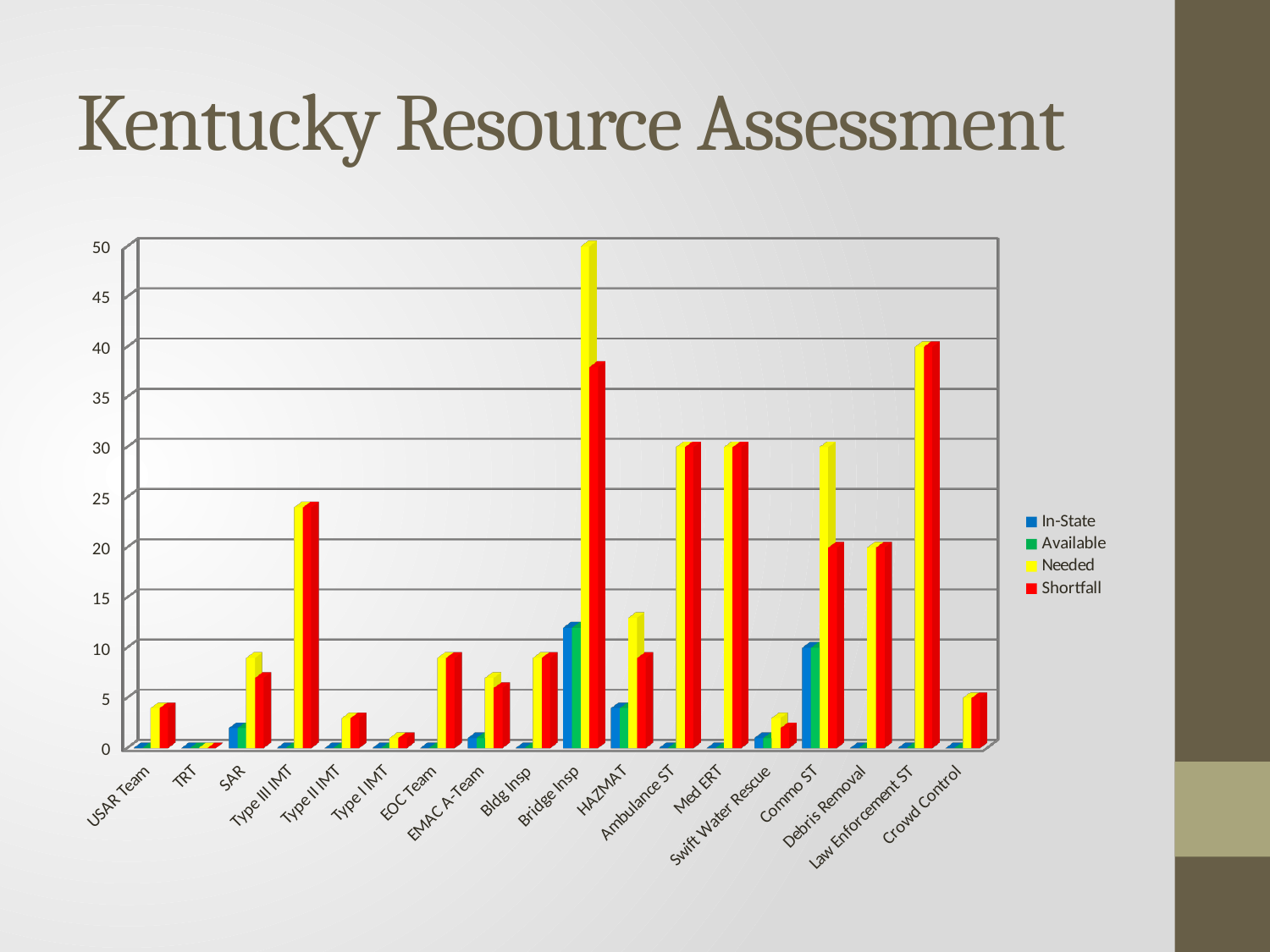
What is the Needed value for Law Enforcement ST? 40 What colour represents the Shortfall series in the legend? Red How many categories are shown along the x axis? 18 Is the Needed value for Bldg Insp greater or less than 10? less What is the Needed value for Bridge Insp? 50 Which has the larger Shortfall value, Type III IMT or HAZMAT? Type III IMT What kind of chart is shown on the slide? Bar chart Is the Needed value for Type III IMT greater or less than 20? greater Which category has the highest Needed value? Bridge Insp Which has the larger In-State value, Bridge Insp or HAZMAT? Bridge Insp How many series does the legend list? 4 Is the Needed value for HAZMAT greater or less than 10? greater